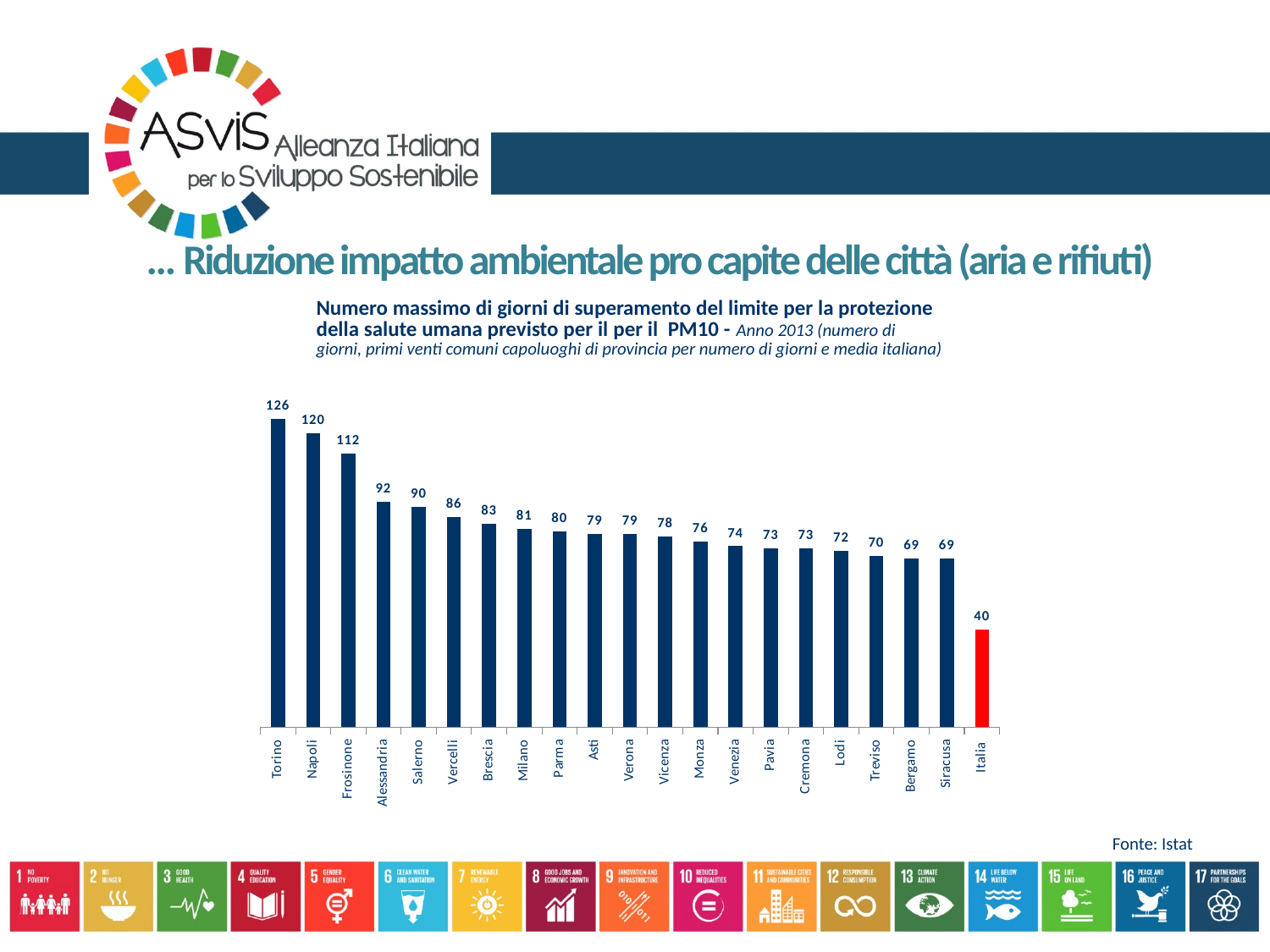
How many categories are shown on the x axis? 21 What kind of chart is this? Bar chart What is the difference between the values for Napoli and Frosinone? 8 What is the value for Torino? 126 What is the value for Milano? 81 What is the value for Italia? 40 Which bar is coloured red? Italia What is the difference between the values for Torino and Italia? 86 Do the values rise or fall from Torino to Siracusa along the x axis? Fall Which category has the lowest value? Italia Which is larger, the value for Alessandria or the value for Vercelli? Alessandria Which category has the highest value? Torino